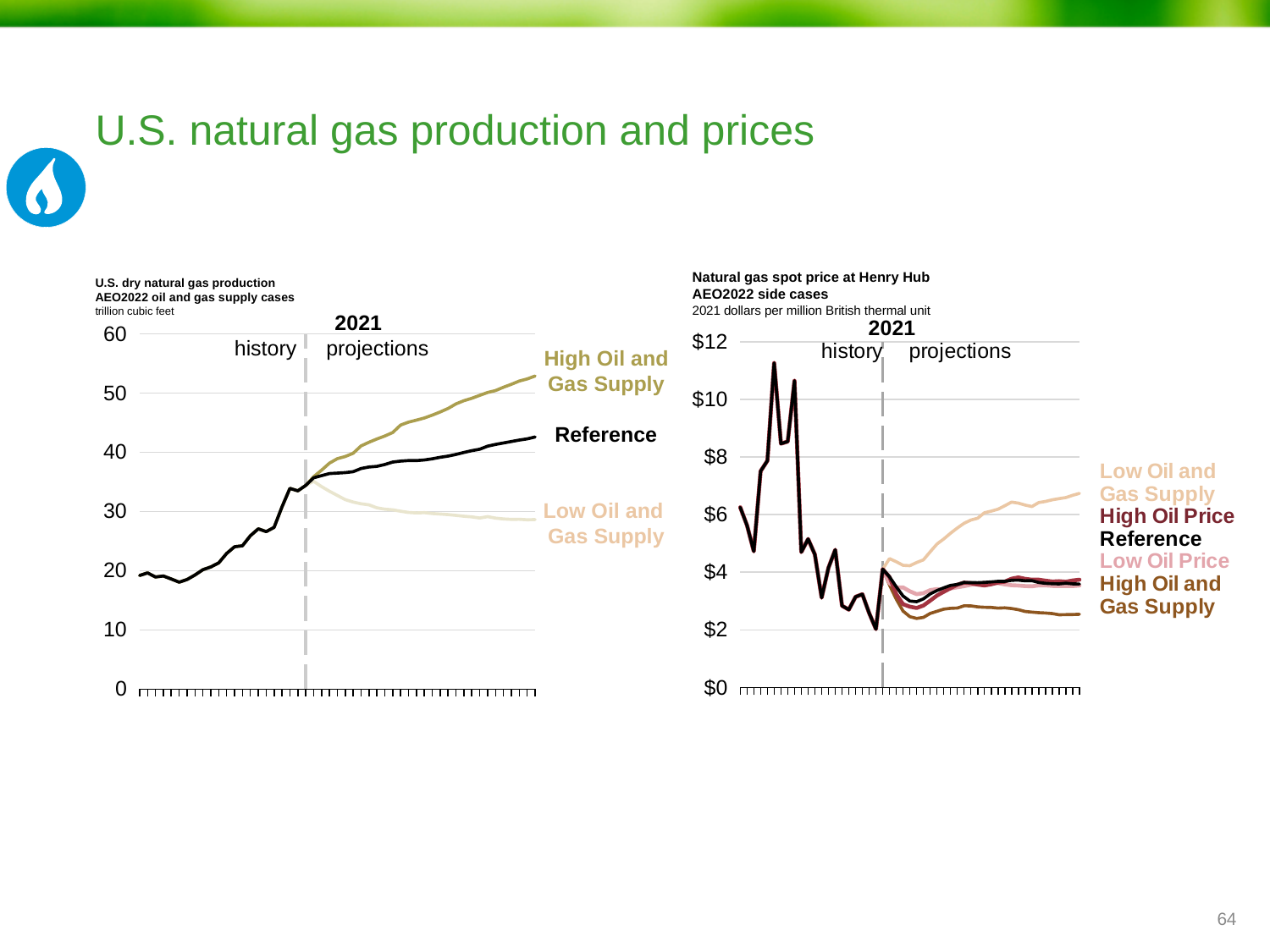
On the 'U.S. dry natural gas production' chart, is the final projected value for the Low Oil and Gas Supply case greater or less than 30? less How many series are labelled on the 'Natural gas spot price at Henry Hub' chart on the right? 5 What kind of chart is the 'U.S. dry natural gas production' chart on the left? line chart On the 'Natural gas spot price at Henry Hub' chart, which case has the highest price at the end of the projection period? Low Oil and Gas Supply On the 'U.S. dry natural gas production' chart, does the Low Oil and Gas Supply line rise or fall over the projection period? fall On the 'U.S. dry natural gas production' chart, is the final projected value for the Reference case greater or less than 40? greater What unit is used on the 'Natural gas spot price at Henry Hub' chart? 2021 dollars per million British thermal unit On the 'U.S. dry natural gas production' chart, which case has the highest production at the end of the projection period? High Oil and Gas Supply On the 'Natural gas spot price at Henry Hub' chart, is the final projected price for the Low Oil and Gas Supply case greater or less than $6? greater How many series are labelled on the 'U.S. dry natural gas production' chart on the left? 3 On the 'Natural gas spot price at Henry Hub' chart, which case has the lowest price at the end of the projection period? High Oil and Gas Supply